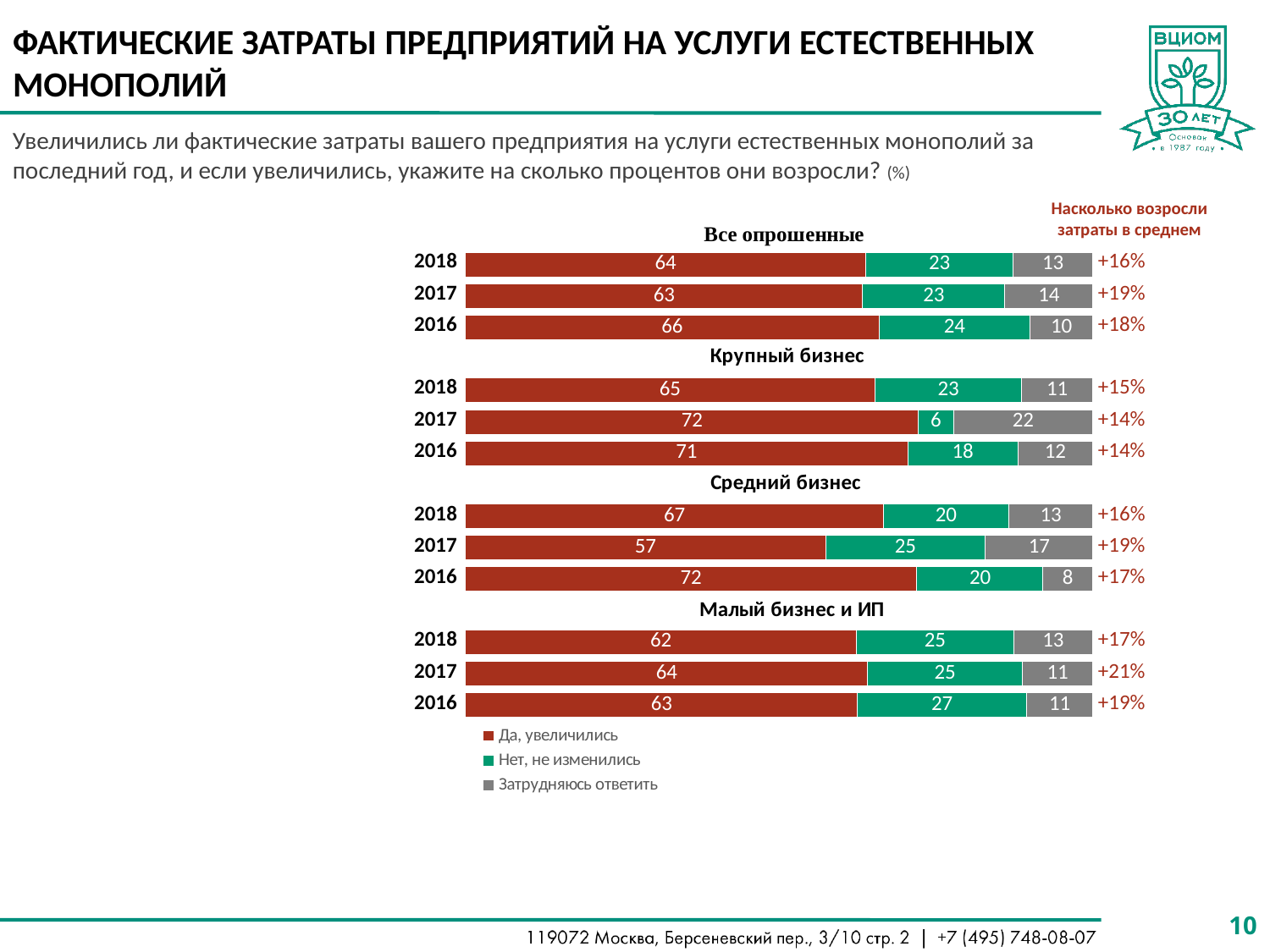
In the "Крупный бизнес" group, which year has the lowest value for "Нет, не изменились"? 2017 What kind of chart is shown on the slide? Stacked bar chart What is the value of "Нет, не изменились" for 2017 in the "Крупный бизнес" group? 6 What average cost increase ("Насколько возросли затраты в среднем") is shown for 2017 in the "Малый бизнес и ИП" group? +21% How many business groups are shown in the chart? 4 What is the value of "Да, увеличились" for 2018 in the "Все опрошенные" group? 64 In the "Средний бизнес" group, which year has the highest value for "Да, увеличились"? 2016 What is the difference between the "Да, увеличились" values for 2016 and 2017 in the "Средний бизнес" group? 15 What is the total of the stacked bar for 2017 in the "Крупный бизнес" group? 100 How many series does the legend list? 3 Which is larger: "Да, увеличились" for 2018 in "Малый бизнес и ИП" or "Да, увеличились" for 2018 in "Крупный бизнес"? Крупный бизнес (65) What is the value of "Затрудняюсь ответить" for 2016 in the "Средний бизнес" group? 8